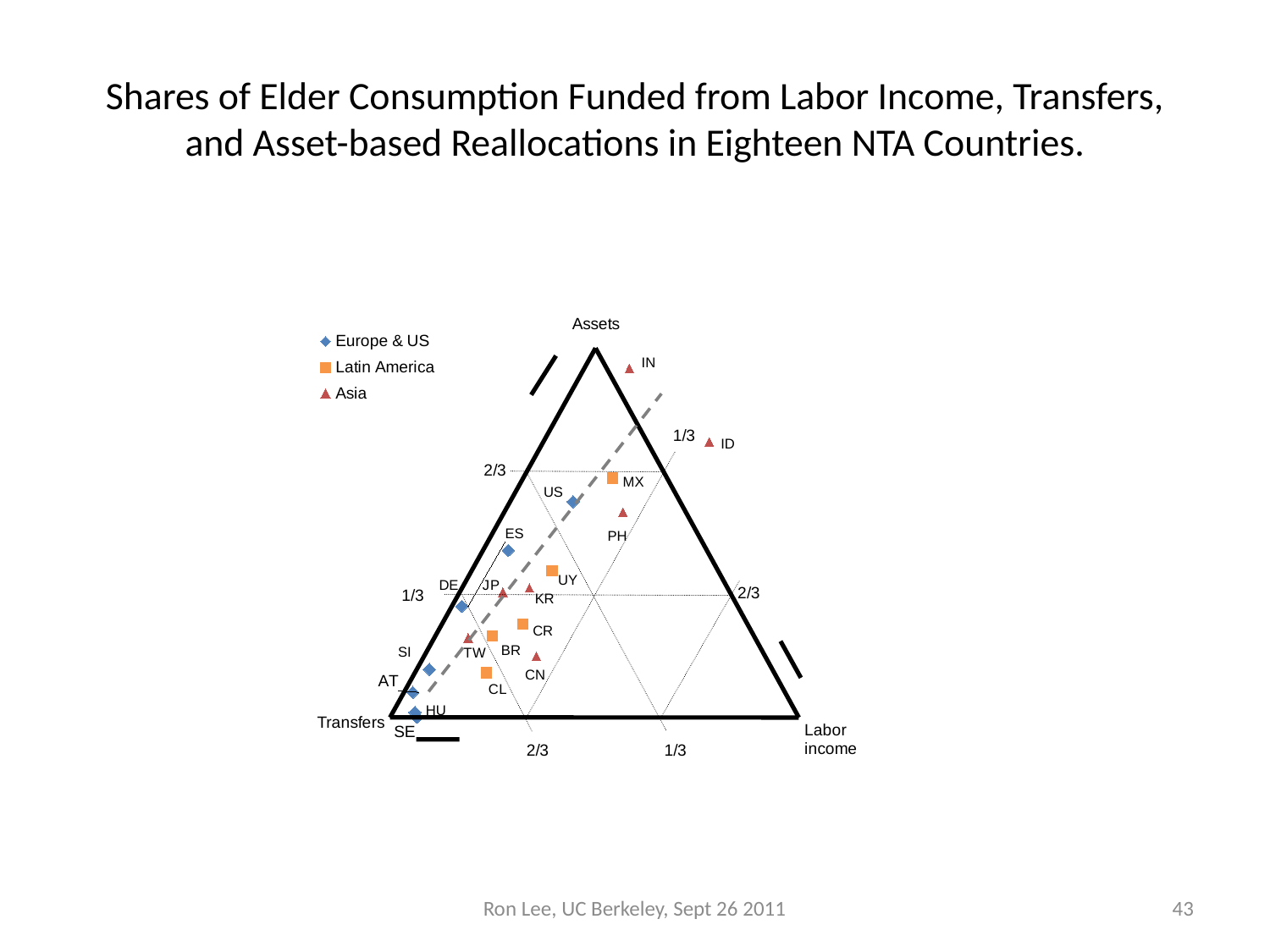
What are the three corners (axes) of the triangle labelled? Assets, Transfers, Labor income Is the asset share for IN greater or less than 2/3? greater Which country's point lies closest to the Transfers corner? SE Is the asset share for CN greater or less than 1/3? less Is the transfers share for SE greater or less than 2/3? greater Which country's point lies closest to the Assets corner? IN What are the three series named in the legend? Europe & US, Latin America, Asia What kind of chart is shown on the slide? Ternary (triangle) scatter plot How many series does the legend list? 3 Which series does the point labelled MX belong to? Latin America Which has the larger asset share, US or CL? US